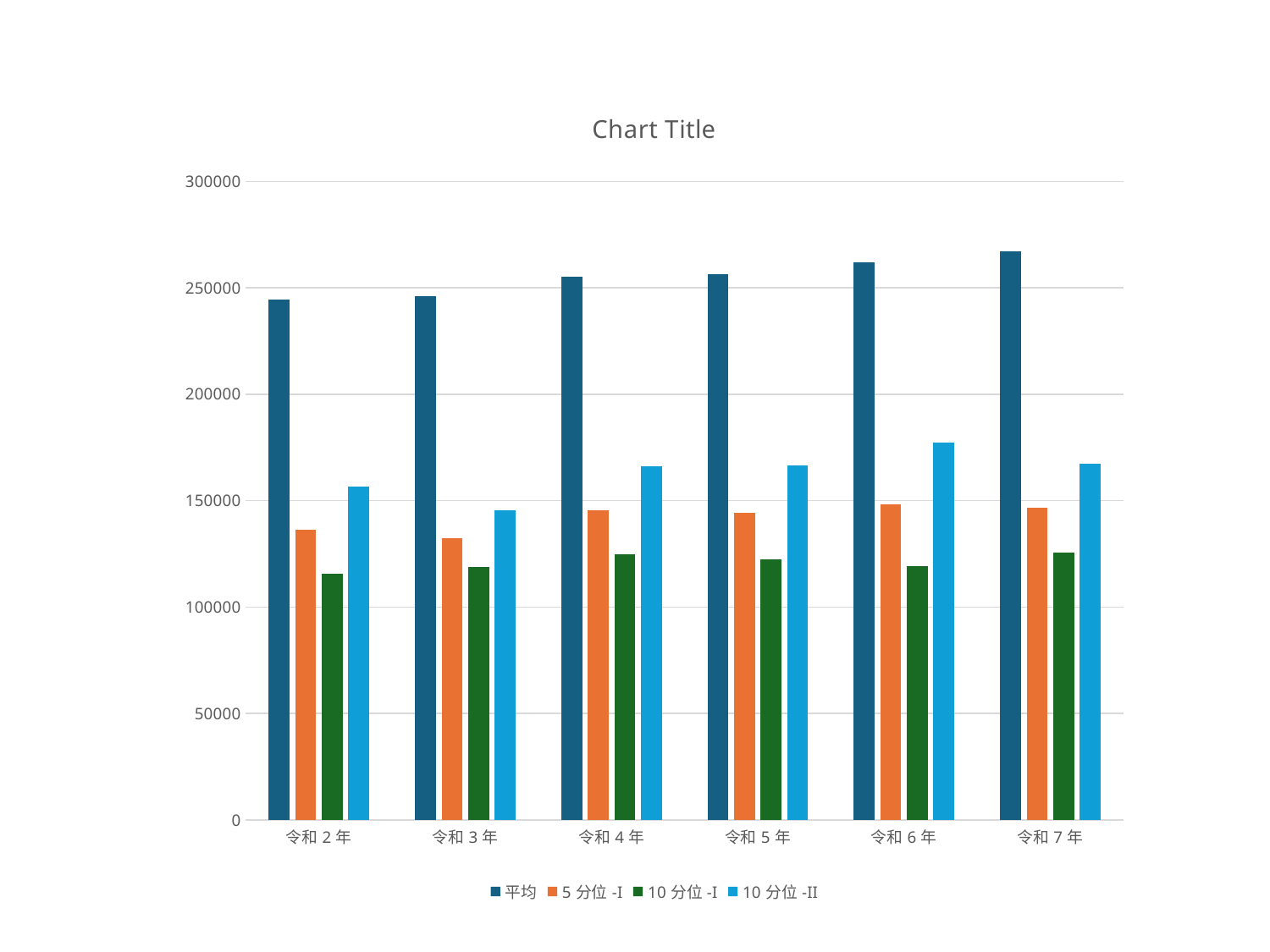
How many series does the legend list? 4 Is the 10分位-II value for 令和6年 greater or less than 150000? greater How many categories (years) are shown on the x axis? 6 In which year is the 10分位-II series highest? 令和6年 Is the 平均 value for 令和7年 greater or less than 250000? greater Does the 平均 series rise or fall from 令和2年 to 令和7年? rise What kind of chart is shown on the slide? bar chart In which year is the 平均 series highest? 令和7年 For 令和2年, which is larger: 5分位-I or 10分位-II? 10分位-II In which year is the 10分位-II series lowest? 令和3年 Is the 平均 value for 令和2年 greater or less than 250000? less